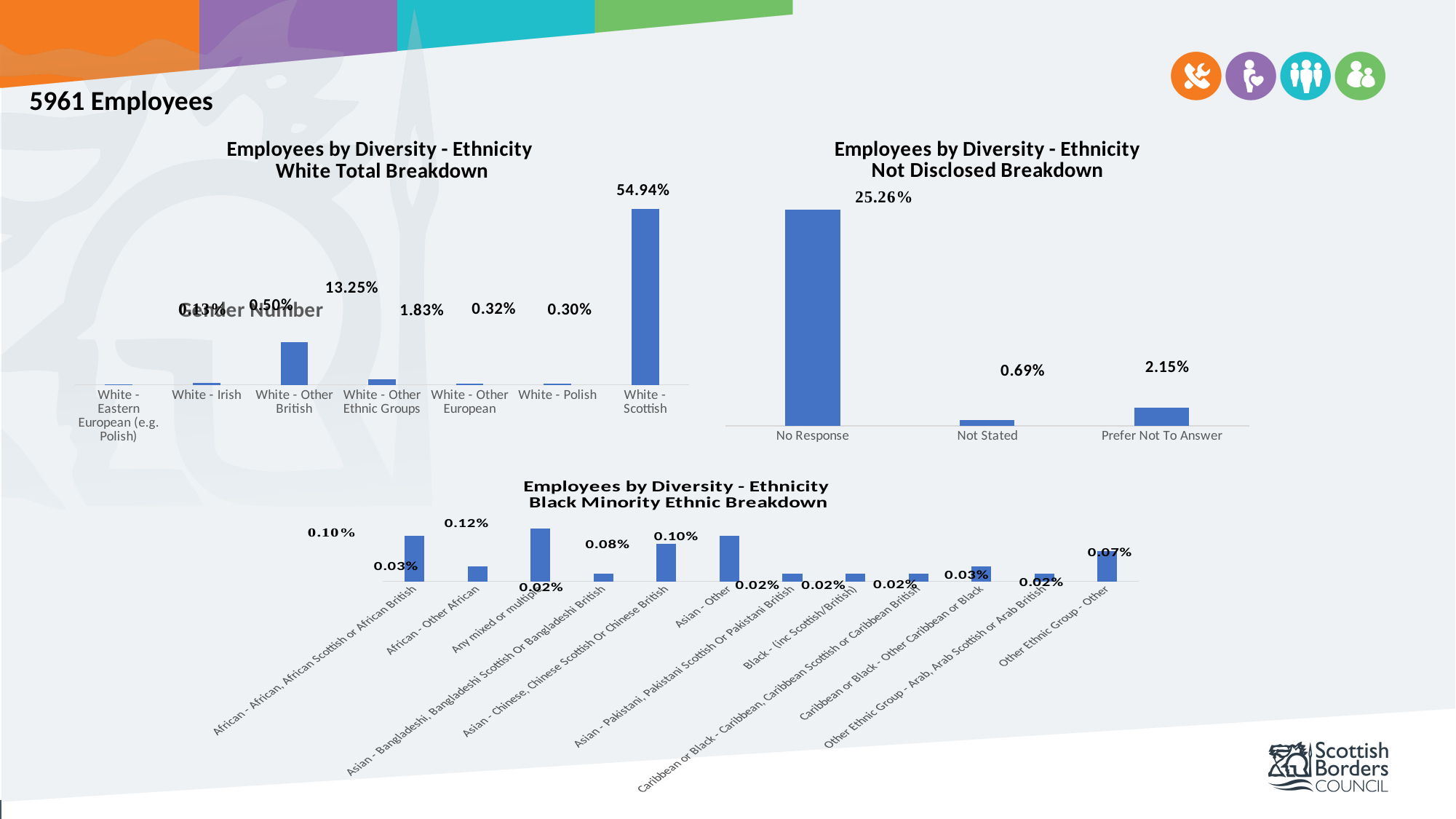
How many categories are shown in the 'Employees by Diversity - Ethnicity White Total Breakdown' chart? 7 In the 'Employees by Diversity - Ethnicity White Total Breakdown' chart, which category has the highest value? White - Scottish In the 'Employees by Diversity - Ethnicity Not Disclosed Breakdown' chart, what is the value for Prefer Not To Answer? 2.15% In the 'Employees by Diversity - Ethnicity Not Disclosed Breakdown' chart, which category has the lowest value? Not Stated In the 'Employees by Diversity - Ethnicity Black Minority Ethnic Breakdown' chart, what is the value for Asian - Other? 0.10% In the 'Employees by Diversity - Ethnicity White Total Breakdown' chart, which is larger, White - Irish or White - Polish? White - Irish What type of chart is the 'Employees by Diversity - Ethnicity Not Disclosed Breakdown' chart? Bar chart In the 'Employees by Diversity - Ethnicity White Total Breakdown' chart, what is the value for White - Other British? 13.25% In the 'Employees by Diversity - Ethnicity White Total Breakdown' chart, what is the value for White - Scottish? 54.94% In the 'Employees by Diversity - Ethnicity Black Minority Ethnic Breakdown' chart, what is the value for Other Ethnic Group - Other? 0.07% In the 'Employees by Diversity - Ethnicity White Total Breakdown' chart, what is the difference between the values for White - Scottish and White - Other British? 41.69% In the 'Employees by Diversity - Ethnicity Not Disclosed Breakdown' chart, what is the difference between No Response and Prefer Not To Answer? 23.11%